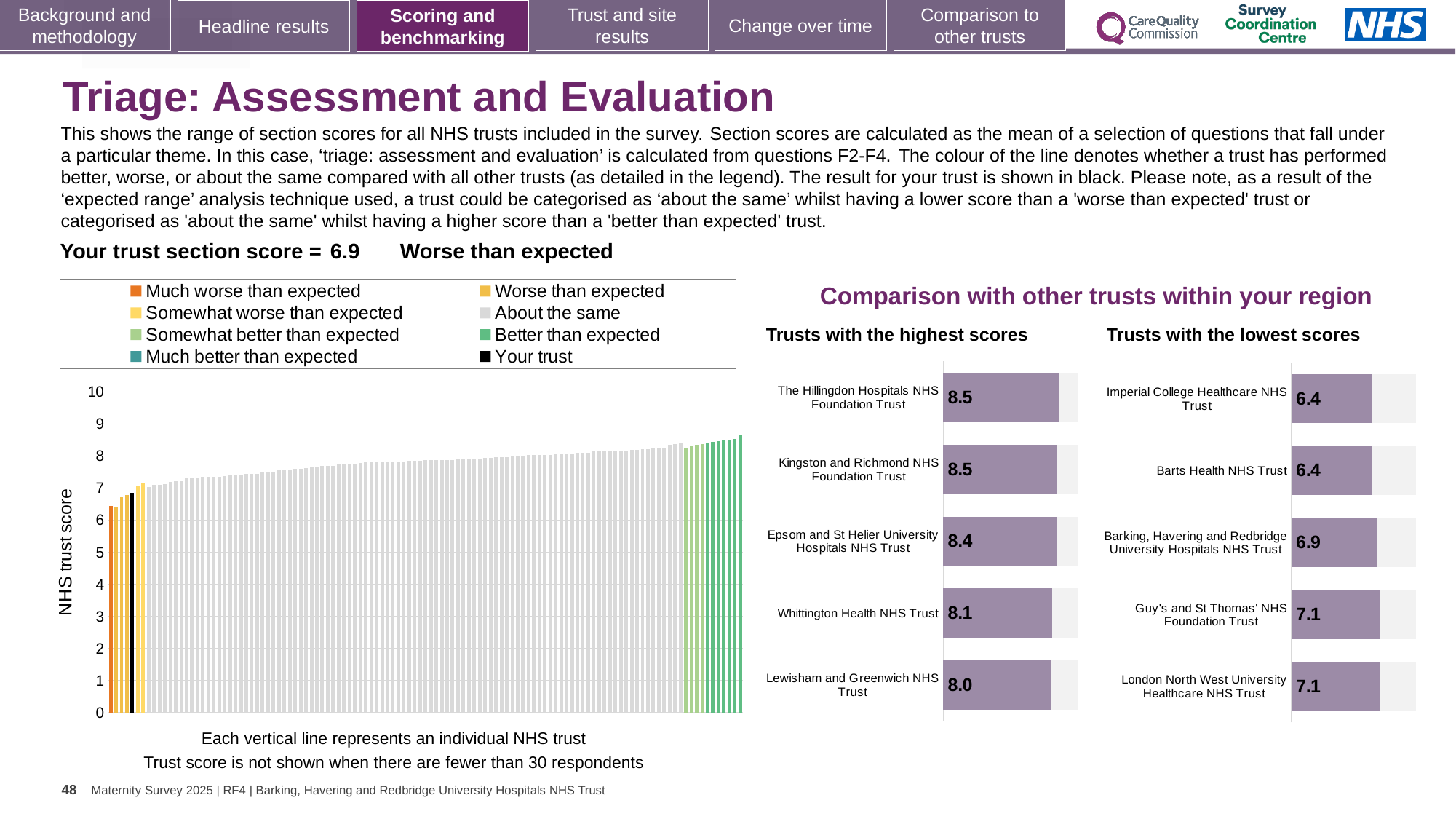
In the 'Trusts with the highest scores' chart, which trust has the lowest score? Lewisham and Greenwich NHS Trust How many trusts are shown in the 'Trusts with the lowest scores' chart? 5 In the 'Trusts with the highest scores' chart, which has the higher score: Whittington Health NHS Trust or Lewisham and Greenwich NHS Trust? Whittington Health NHS Trust What kind of chart is the 'NHS trust score' chart on the left of the slide? Bar chart In the 'Trusts with the highest scores' chart, what is the difference between the scores of The Hillingdon Hospitals NHS Foundation Trust and Lewisham and Greenwich NHS Trust? 0.5 In the 'Trusts with the lowest scores' chart, what is the score for Guy's and St Thomas' NHS Foundation Trust? 7.1 In the 'Trusts with the lowest scores' chart, what is the score for Barts Health NHS Trust? 6.4 How many entries does the legend above the 'NHS trust score' chart list? 8 In the 'Trusts with the lowest scores' chart, what is the difference between the scores of Barking, Havering and Redbridge University Hospitals NHS Trust and Imperial College Healthcare NHS Trust? 0.5 In the 'Trusts with the highest scores' chart, what is the score for Whittington Health NHS Trust? 8.1 In the 'Trusts with the highest scores' chart, what is the score for Epsom and St Helier University Hospitals NHS Trust? 8.4 In the 'NHS trust score' chart on the left, do the values rise or fall from left to right? Rise